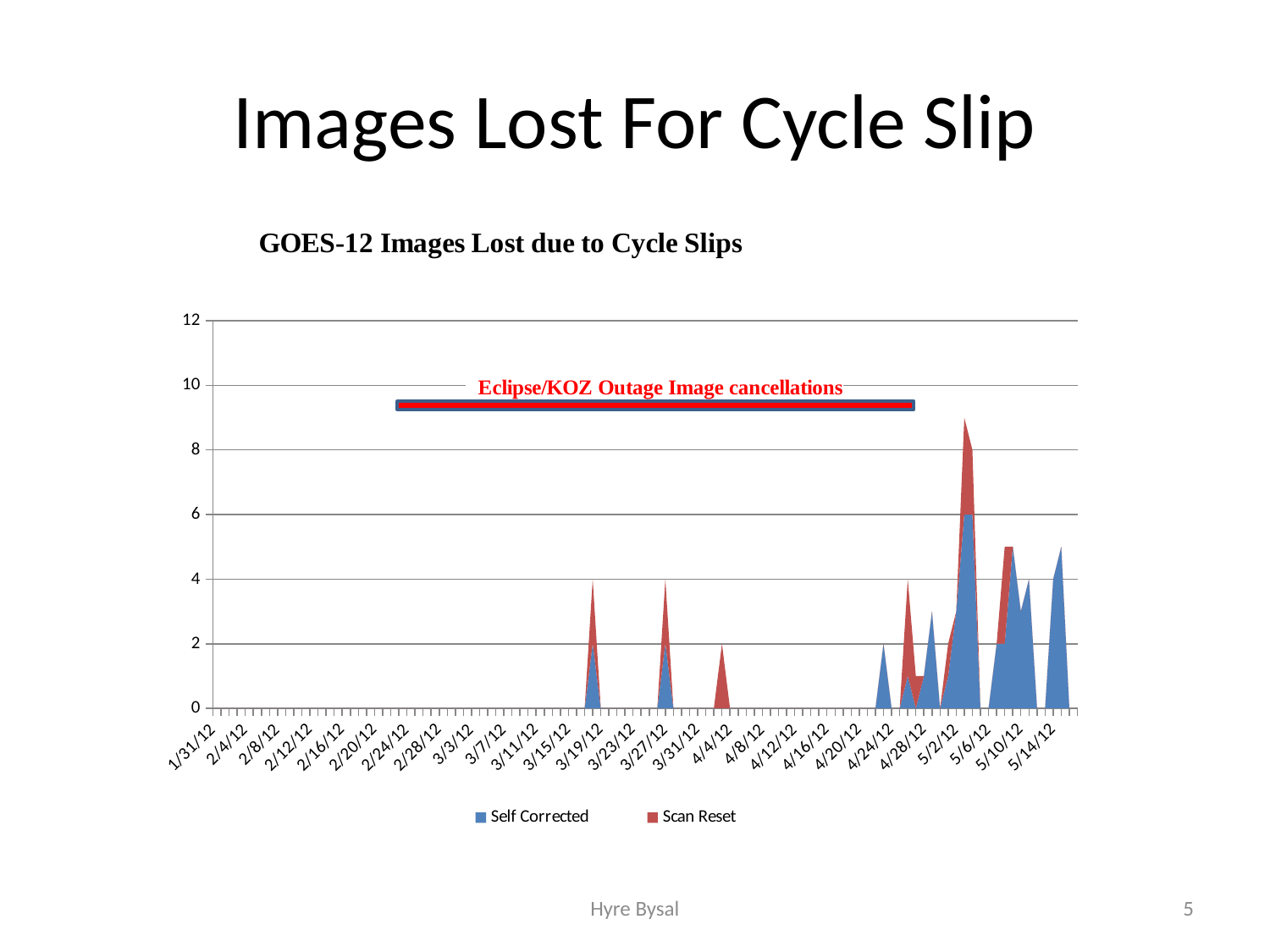
Is the highest peak on the chart greater or less than 10? less What is the maximum value shown on the vertical axis? 12 How many series does the legend list? 2 What kind of chart is shown on the slide? Area chart Which series is shown in red? Scan Reset Is the highest peak on the chart greater or less than 8? greater What is the title of the chart? GOES-12 Images Lost due to Cycle Slips Is the spike near 3/19/12 greater or less than 2? greater